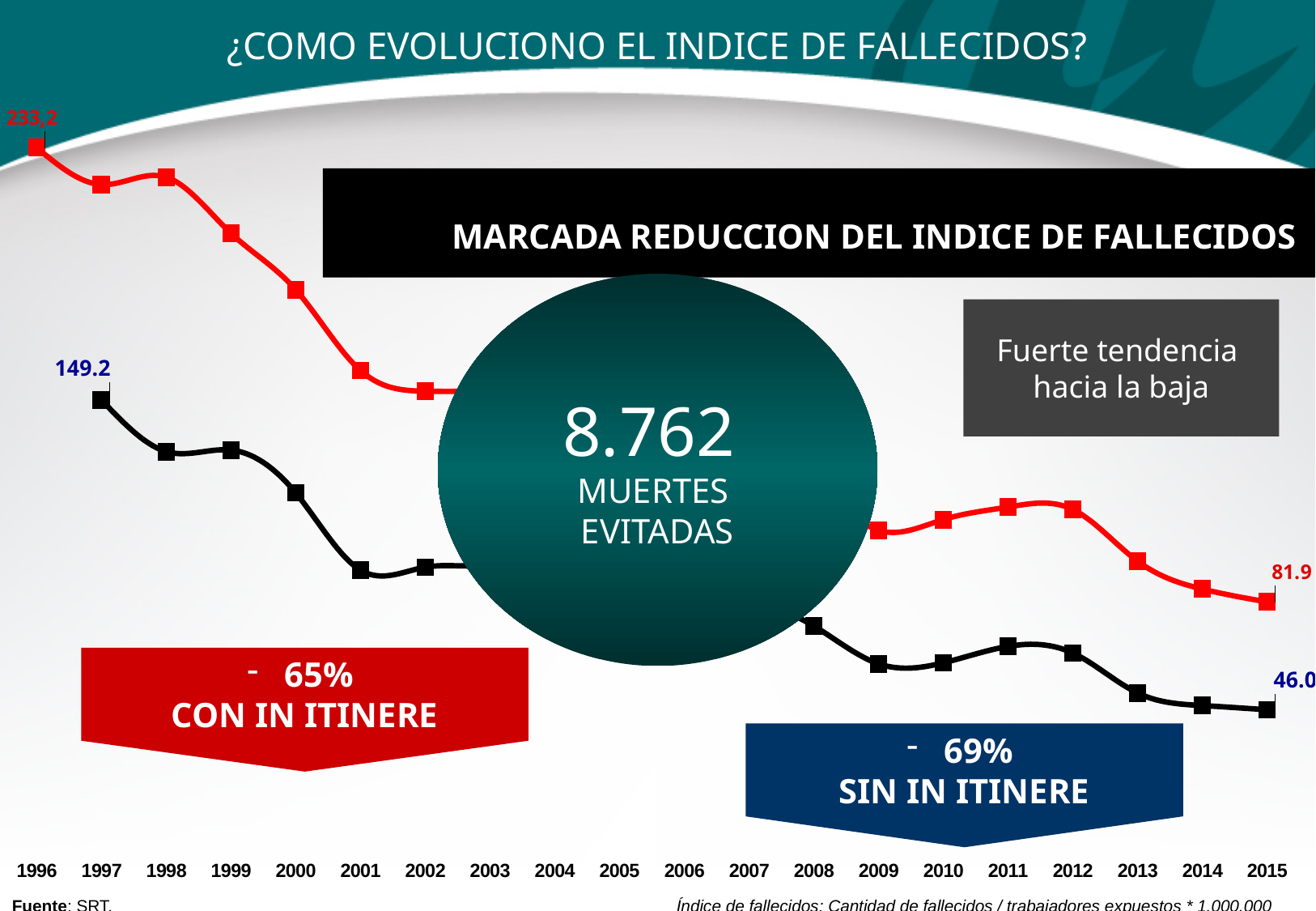
What kind of chart is shown on the slide? line chart Does the black line (sin in itinere) rise or fall overall from 1996 to 2015? fall In which year does the red line (con in itinere) reach its highest value? 1996 What is the value of the black line (sin in itinere) in 2015? 46.0 What percentage change is shown for the 'CON IN ITINERE' series? -65% What is the value of the red line (con in itinere) in 2015? 81.9 What is the value of the red line (con in itinere) in 1996? 233,2 How many years are shown on the x axis? 20 How many data series (lines) are plotted on the chart? 2